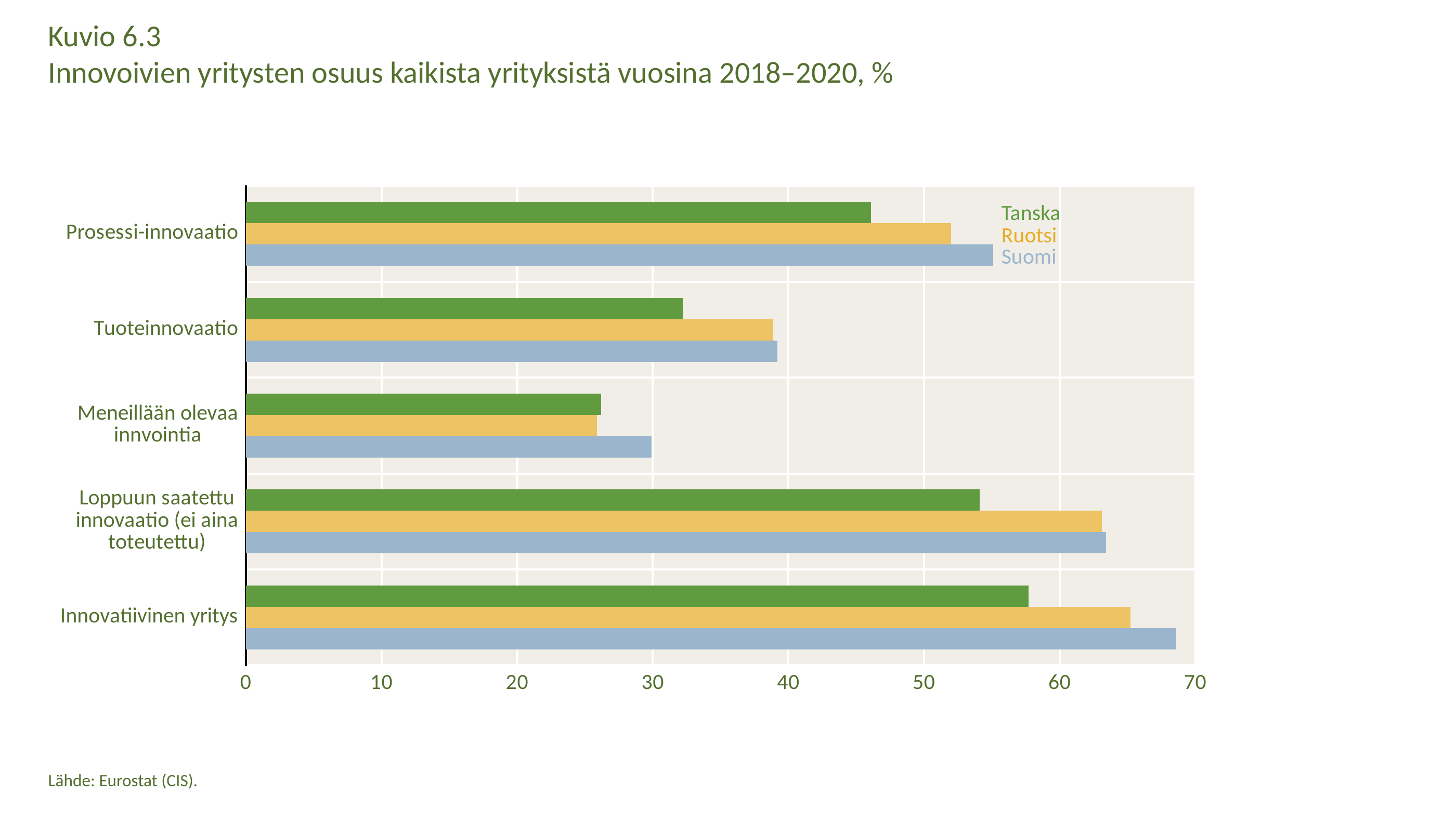
Which series has the highest value in the Innovatiivinen yritys category? Suomi What kind of chart is shown on the slide? bar chart For the Suomi series, which category has the lowest value? Meneillään olevaa innvointia Is the value for Tanska in the Meneillään olevaa innvointia category greater or less than 30? less In the Prosessi-innovaatio category, which is larger: the value for Suomi or the value for Tanska? Suomi Is the value for Ruotsi in the Prosessi-innovaatio category greater or less than 50? greater How many series does the legend list? 3 Is the value for Suomi in the Innovatiivinen yritys category greater or less than 60? greater Which series are listed in the legend? Tanska, Ruotsi, Suomi In the Innovatiivinen yritys category, which is larger: the value for Ruotsi or the value for Tanska? Ruotsi How many categories are shown on the vertical axis? 5